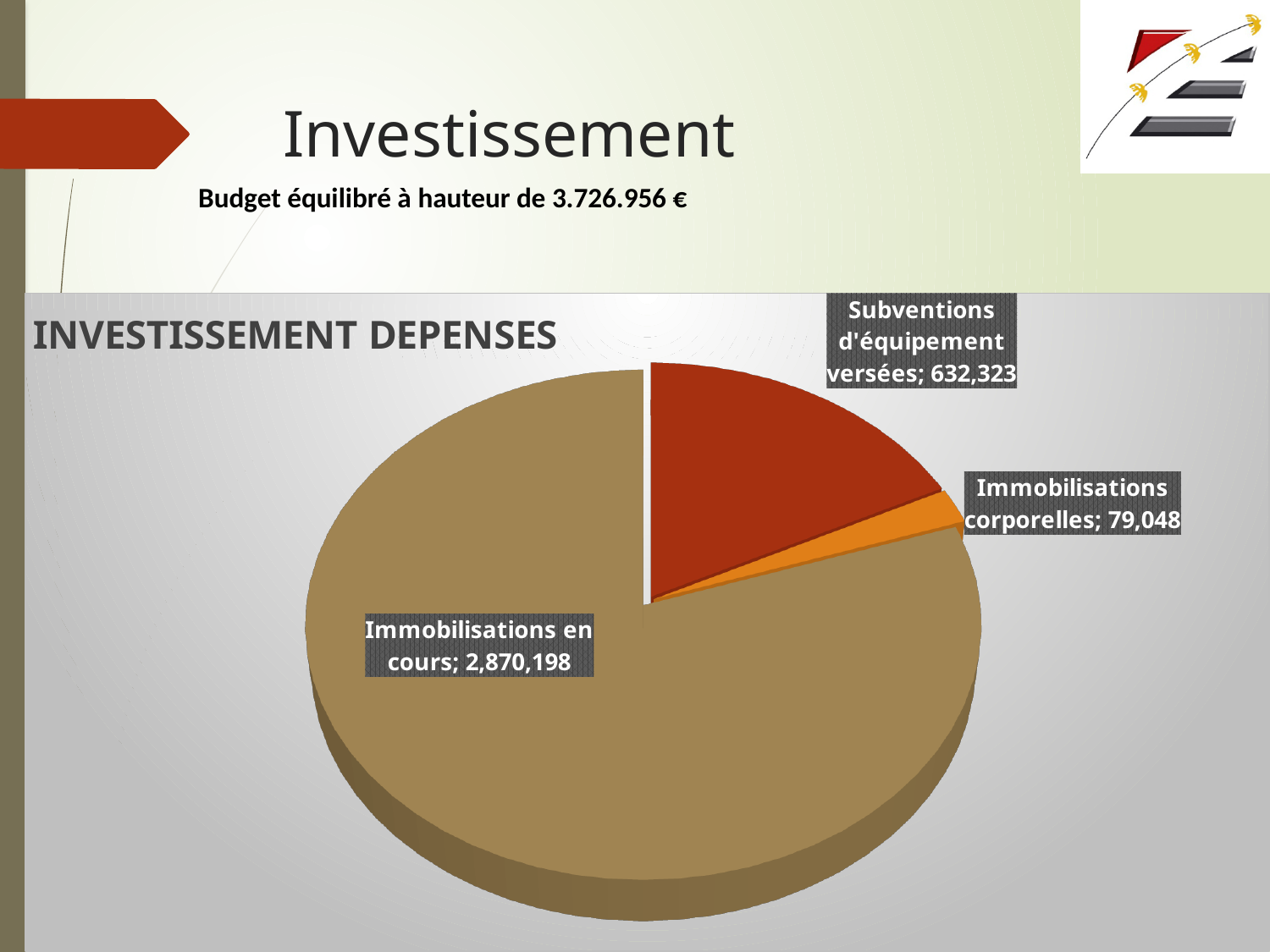
Which is larger, Subventions d'équipement versées or Immobilisations corporelles? Subventions d'équipement versées What is the difference between Subventions d'équipement versées and Immobilisations corporelles? 553,275 What is the title of the chart? INVESTISSEMENT DEPENSES What type of chart is shown on the slide? Pie chart How many slices does the pie chart have? 3 What is the value for Immobilisations corporelles? 79,048 What is the value for Immobilisations en cours? 2,870,198 Which category has the smallest slice of the pie? Immobilisations corporelles What is the difference between Immobilisations en cours and Subventions d'équipement versées? 2,237,875 What is the value for Subventions d'équipement versées? 632,323 Which category has the largest slice of the pie? Immobilisations en cours